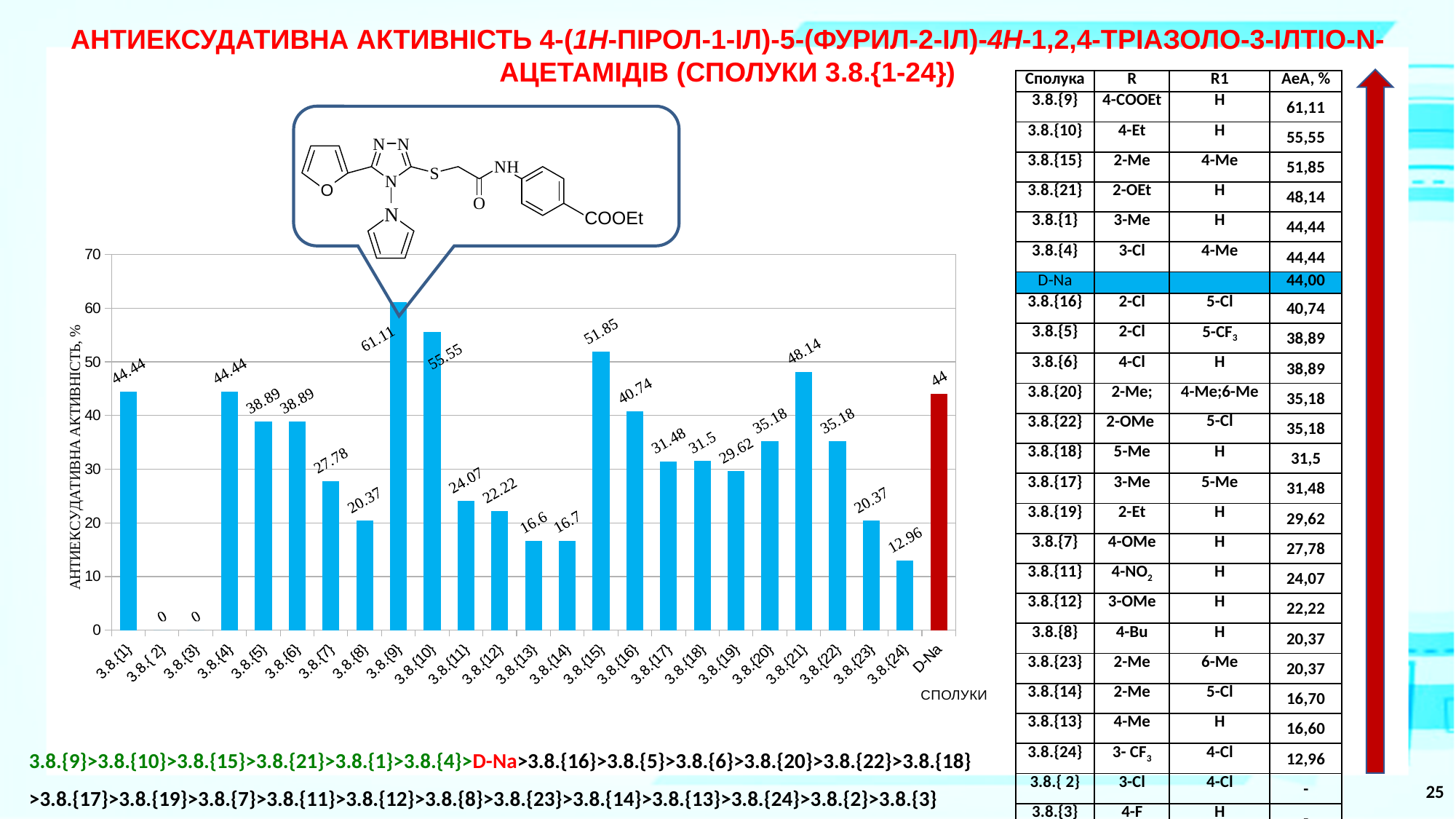
How many categories are shown on the x axis of the bar chart? 25 What is the difference between the values for 3.8.{9} and 3.8.{10}? 5.56 What is the value for 3.8.{9} in the bar chart? 61.11 What is the label of the y axis of the bar chart? АНТИЕКСУДАТИВНА АКТИВНІСТЬ, % What is the value for 3.8.{24} in the bar chart? 12.96 What is the value for D-Na in the bar chart? 44 What kind of chart is shown on the slide? bar chart Is the value for 3.8.{16} greater or less than 40? greater How many categories in the bar chart have a value of 0? 2 Which category has the highest value in the bar chart? 3.8.{9} Which is larger, the value for 3.8.{15} or the value for 3.8.{21}? 3.8.{15} Which category has the lowest non-zero value in the bar chart? 3.8.{24}